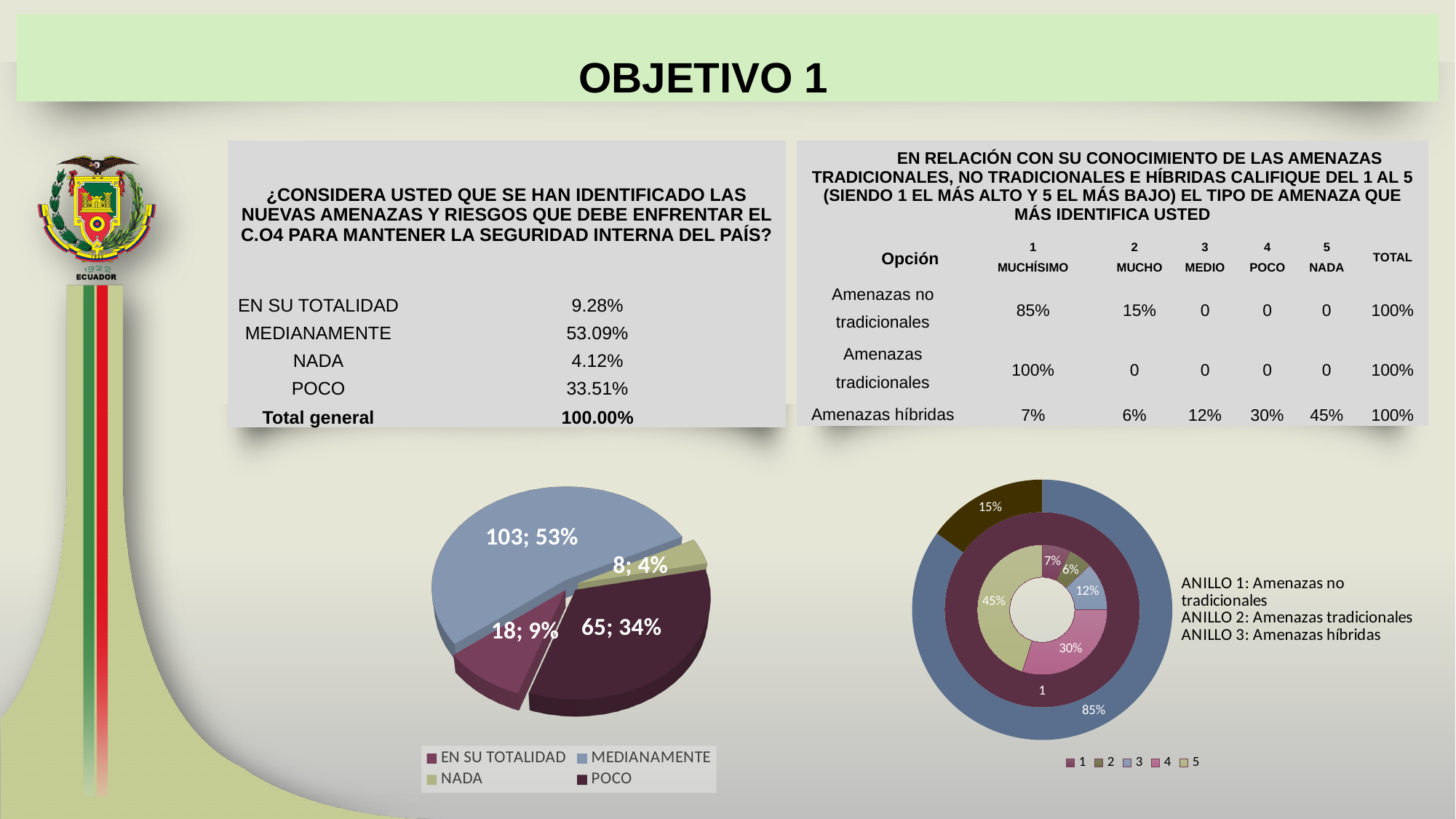
In the bottom-left pie chart, what share of the pie does POCO represent? 34% What kind of chart is the bottom-left chart on the slide? Pie chart In the bottom-left pie chart, what is the data label shown for MEDIANAMENTE? 103; 53% In the bottom-left pie chart, which category has the smallest slice? NADA How many slices does the bottom-left pie chart have? 4 In the bottom-right doughnut chart, what is the largest percentage label shown on the outer ring (Anillo 1)? 85% In the bottom-left pie chart, which category has the largest slice? MEDIANAMENTE What kind of chart is the bottom-right chart on the slide? Doughnut chart In the bottom-left pie chart, what is the difference between the count for MEDIANAMENTE (103) and the count for POCO (65)? 38 In the bottom-right doughnut chart, what is the largest percentage label shown on the innermost ring (Anillo 3)? 45% How many entries does the legend of the bottom-right doughnut chart list? 5 In the bottom-left pie chart, which slice is larger: EN SU TOTALIDAD or NADA? EN SU TOTALIDAD